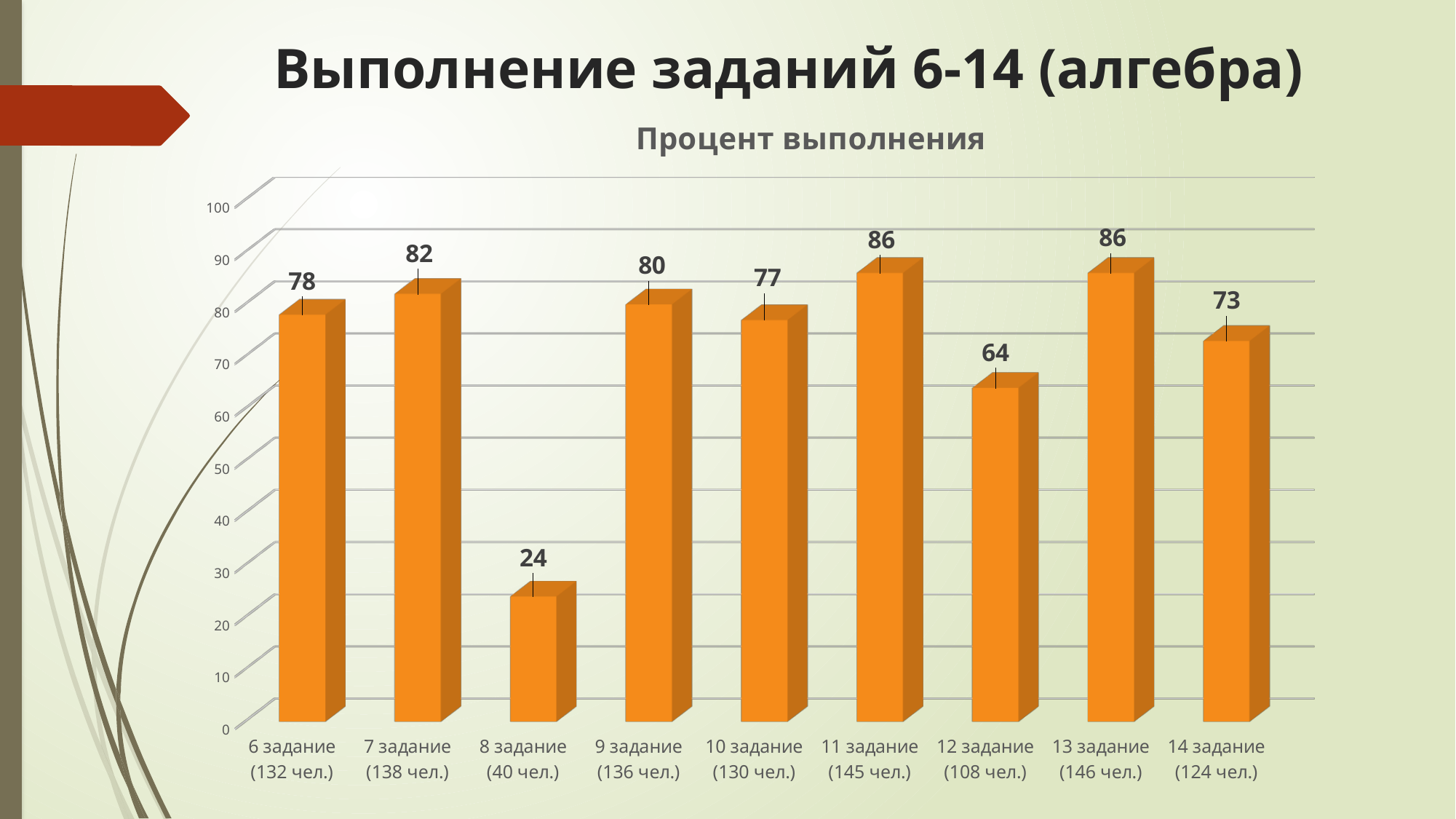
What is the difference between the values for 7 задание and 8 задание? 58 What kind of chart is shown on the slide? bar chart Which category has the lowest value? 8 задание (40 чел.) What is the title of the chart? Процент выполнения What is the value for 12 задание (108 чел.)? 64 What is the value for 8 задание (40 чел.)? 24 What is the value for 14 задание (124 чел.)? 73 What is the highest value shown on the chart? 86 How many categories are shown on the chart? 9 Is the value for 10 задание greater or less than 70? greater What is the difference between the values for 11 задание and 12 задание? 22 Which is larger, the value for 6 задание or the value for 9 задание? 9 задание